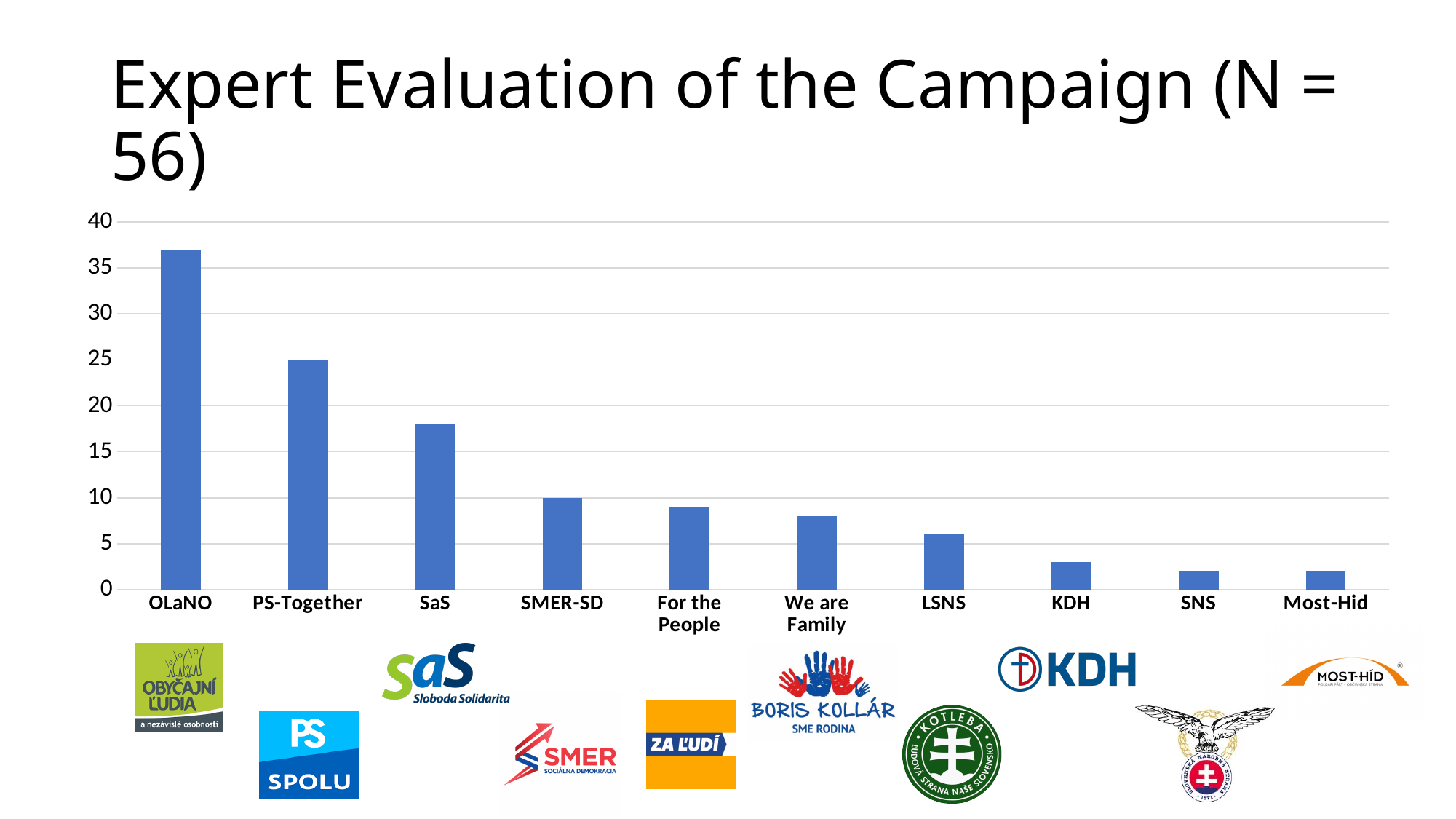
Is the value for OLaNO greater or less than 35? greater How many parties (categories) are shown on the x axis of the chart? 10 What kind of chart is shown on the slide? bar chart Which has a larger value, LSNS or KDH? LSNS Which party has the highest value in the chart? OLaNO Is the value for SaS greater or less than 20? less Do the values generally rise or fall moving from left to right along the x axis? fall Which has a larger value, SaS or SMER-SD? SaS Is the value for KDH greater or less than 5? less What is the title of the chart on the slide? Expert Evaluation of the Campaign (N = 56)